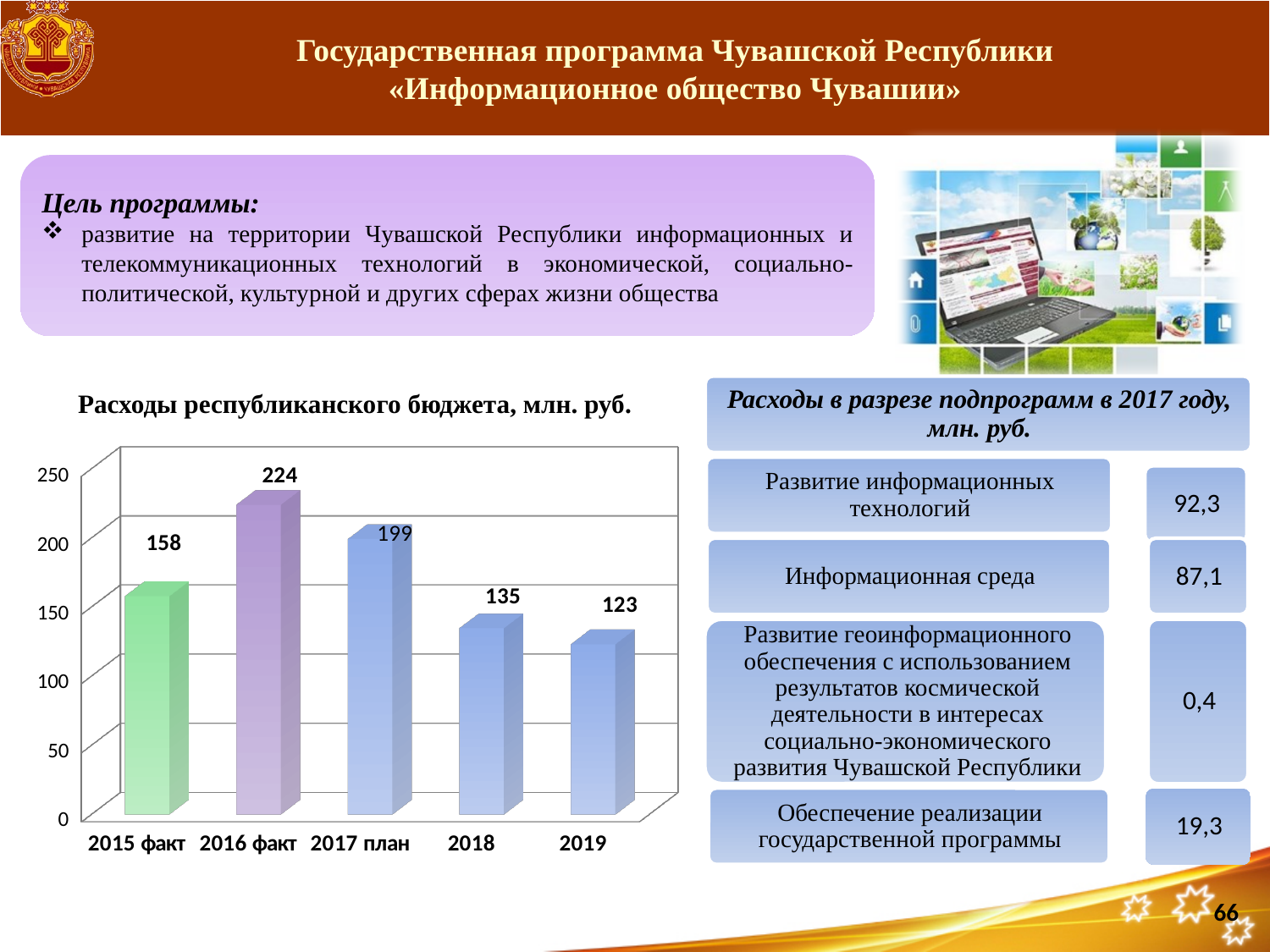
Is the value for 2016 факт greater or less than 200 in the chart 'Расходы республиканского бюджета, млн. руб.'? greater Which category has the highest value in the chart 'Расходы республиканского бюджета, млн. руб.'? 2016 факт What is the value for 2015 факт in the chart 'Расходы республиканского бюджета, млн. руб.'? 158 What is the value for 2017 план in the chart 'Расходы республиканского бюджета, млн. руб.'? 199 In the chart 'Расходы республиканского бюджета, млн. руб.', do the values rise or fall from 2017 план to 2019? fall What kind of chart is 'Расходы республиканского бюджета, млн. руб.'? bar chart What is the difference between the values for 2016 факт and 2015 факт in the chart 'Расходы республиканского бюджета, млн. руб.'? 66 Which category has the lowest value in the chart 'Расходы республиканского бюджета, млн. руб.'? 2019 What is the value for 2019 in the chart 'Расходы республиканского бюджета, млн. руб.'? 123 Which is larger in the chart 'Расходы республиканского бюджета, млн. руб.': the value for 2017 план or the value for 2018? 2017 план How many categories are shown on the x axis of the chart 'Расходы республиканского бюджета, млн. руб.'? 5 What is the difference between the values for 2018 and 2019 in the chart 'Расходы республиканского бюджета, млн. руб.'? 12